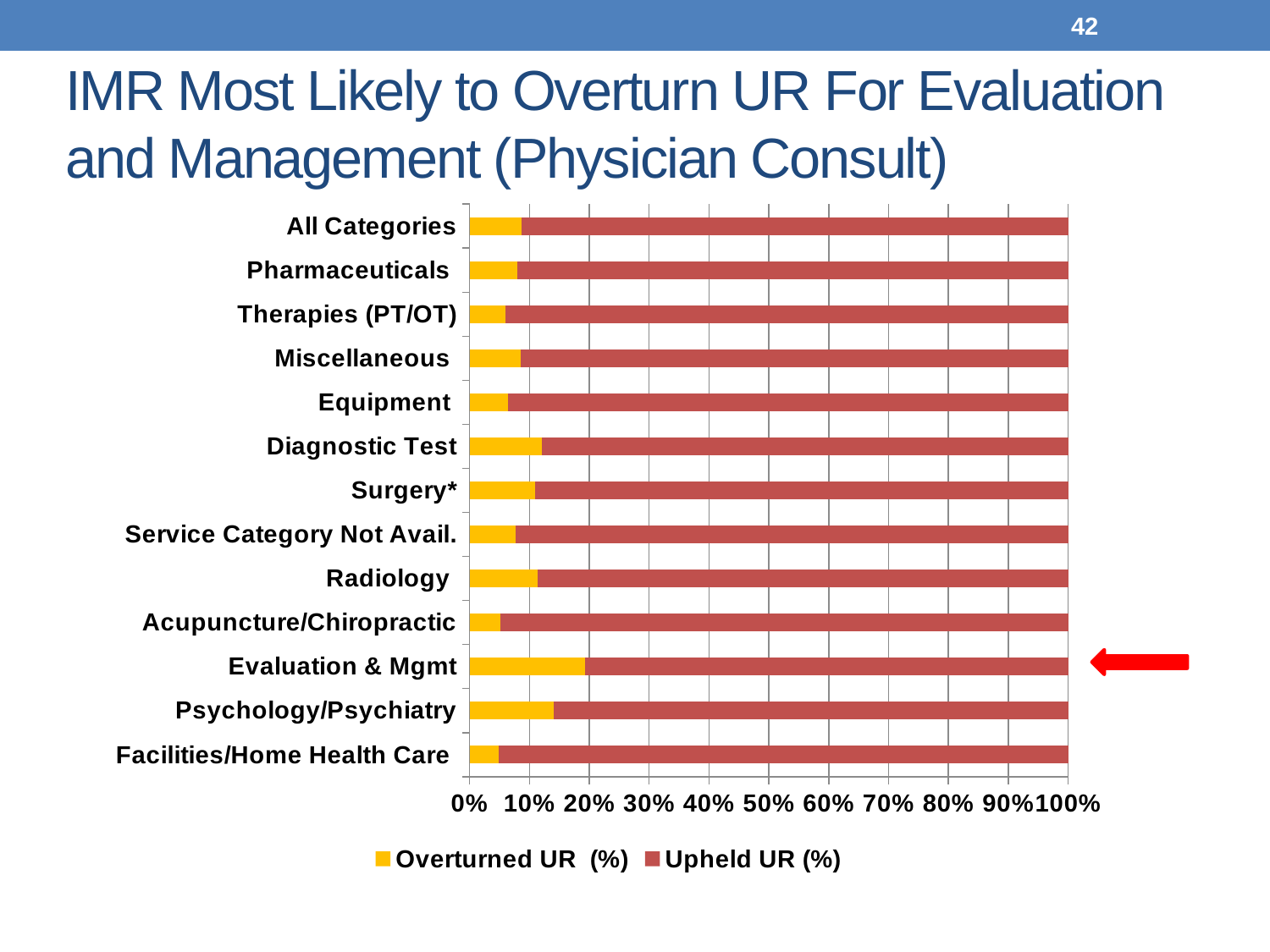
Is the Overturned UR (%) value for Therapies (PT/OT) greater or less than 10%? less Is the Overturned UR (%) value for Evaluation & Mgmt greater or less than 10%? greater How many series does the legend list? 2 What is the total of the stacked bar for All Categories? 100% Which series is shown in yellow in the legend? Overturned UR (%) Which category has the largest Overturned UR (%) share? Evaluation & Mgmt Which has the larger Overturned UR (%) value, Evaluation & Mgmt or Therapies (PT/OT)? Evaluation & Mgmt Is the Upheld UR (%) value for Evaluation & Mgmt greater or less than 90%? less What kind of chart is shown on the slide? Stacked bar chart How many categories are plotted on the chart? 13 Which has the larger Upheld UR (%) value, Therapies (PT/OT) or Evaluation & Mgmt? Therapies (PT/OT)